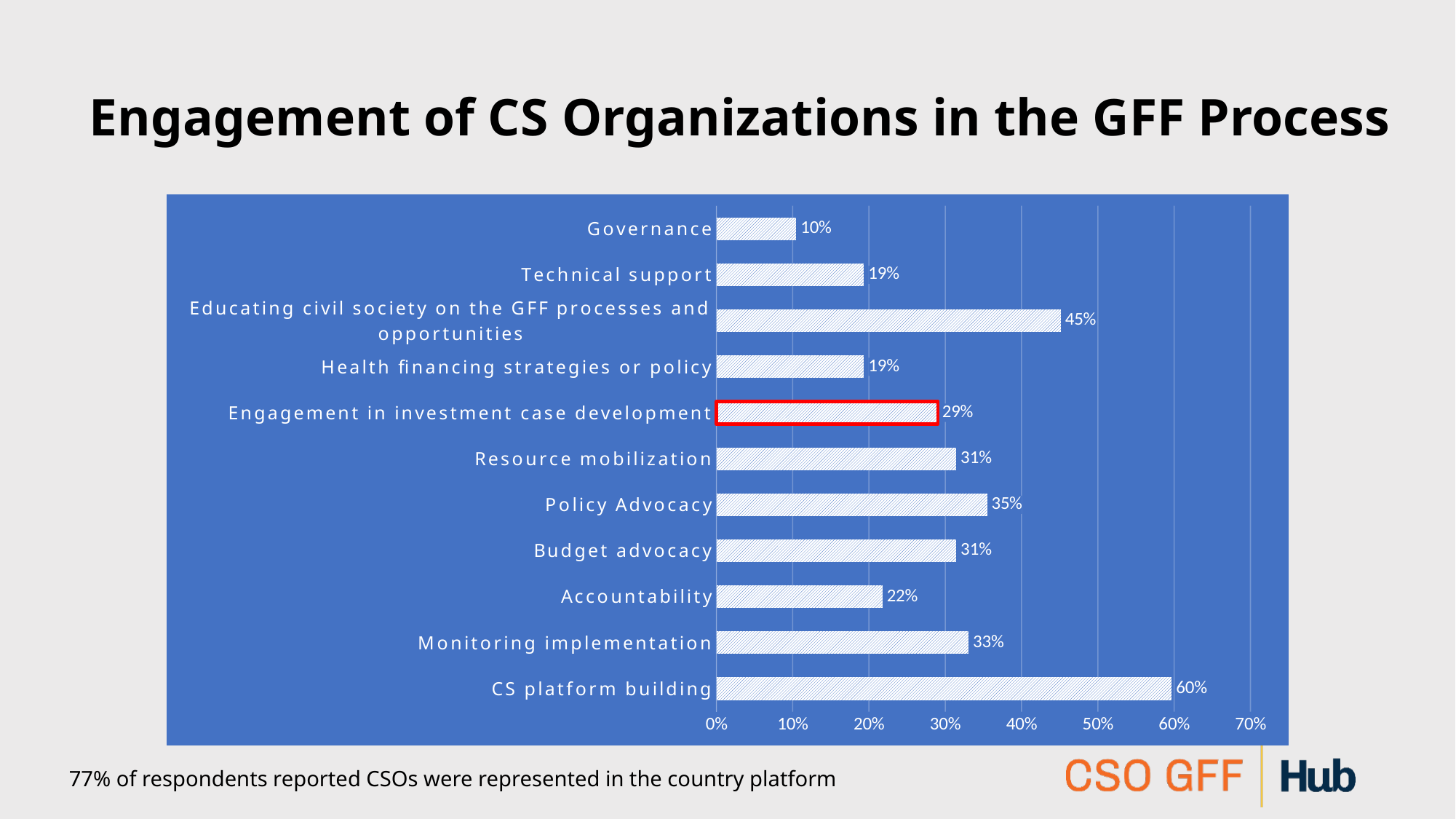
What is the value for Engagement in investment case development? 29% What is the value for CS platform building? 60% Which is larger, the value for Monitoring implementation or the value for Resource mobilization? Monitoring implementation What is the difference between the values for CS platform building and Governance? 50% Which bar is outlined in red? Engagement in investment case development Is the value for Accountability greater or less than 30%? less How many categories are shown in the chart? 11 What is the value for Educating civil society on the GFF processes and opportunities? 45% Which category has the highest value? CS platform building Which category has the lowest value? Governance What is the difference between the values for Policy Advocacy and Accountability? 13% What kind of chart is shown on the slide? bar chart